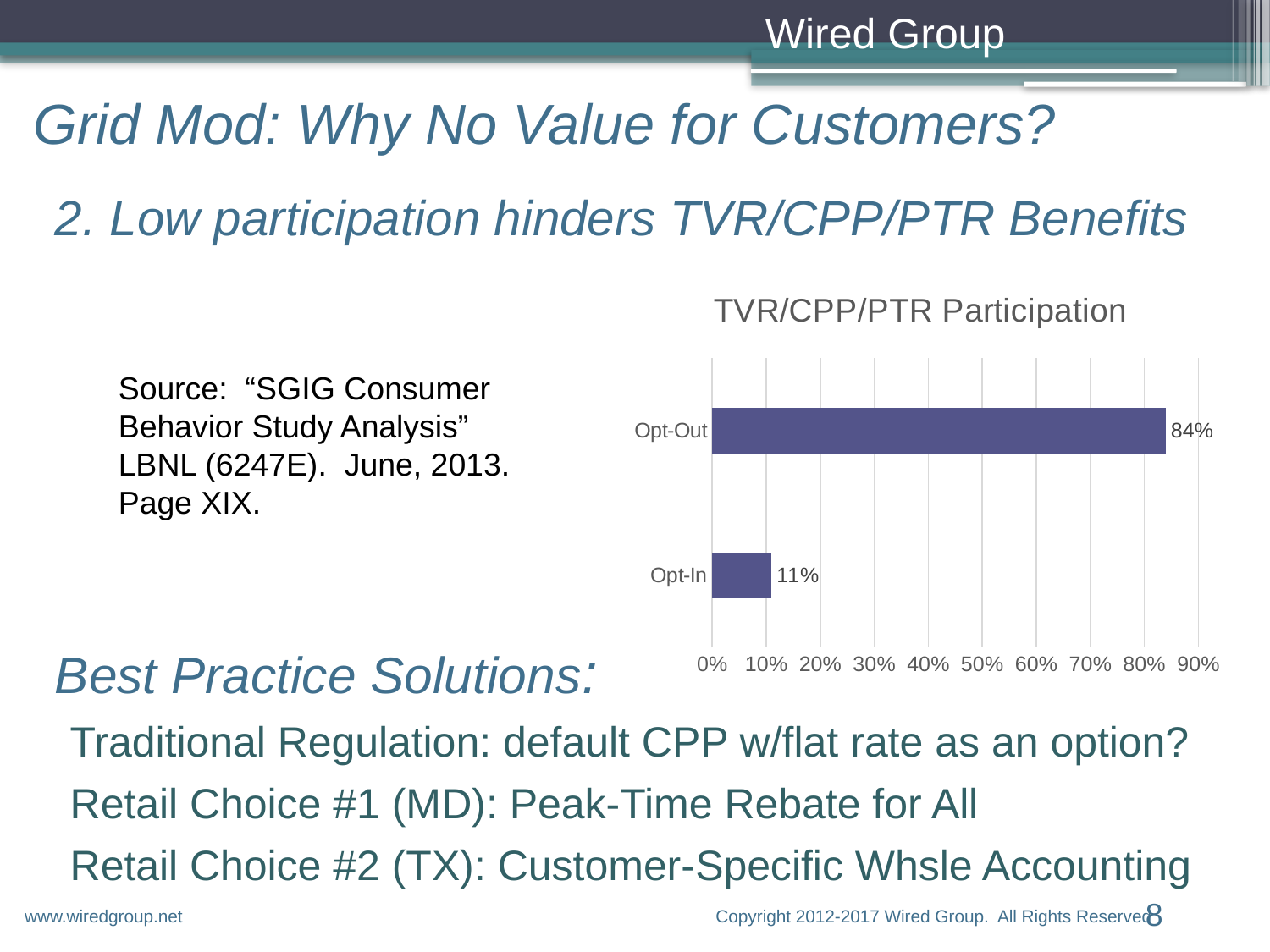
Which is larger, the value for Opt-Out or the value for Opt-In? Opt-Out Which category has the highest participation? Opt-Out Is the value for Opt-In greater or less than 20%? less What is the title of the chart? TVR/CPP/PTR Participation How many categories are shown in the chart? 2 Is the value for Opt-Out greater or less than 50%? greater What kind of chart is shown on the slide? Bar chart What is the participation value for Opt-In? 11% Which category has the lowest participation? Opt-In What is the difference between the Opt-Out and Opt-In participation values? 73% What is the maximum value shown on the chart's x axis? 90% What is the participation value for Opt-Out? 84%